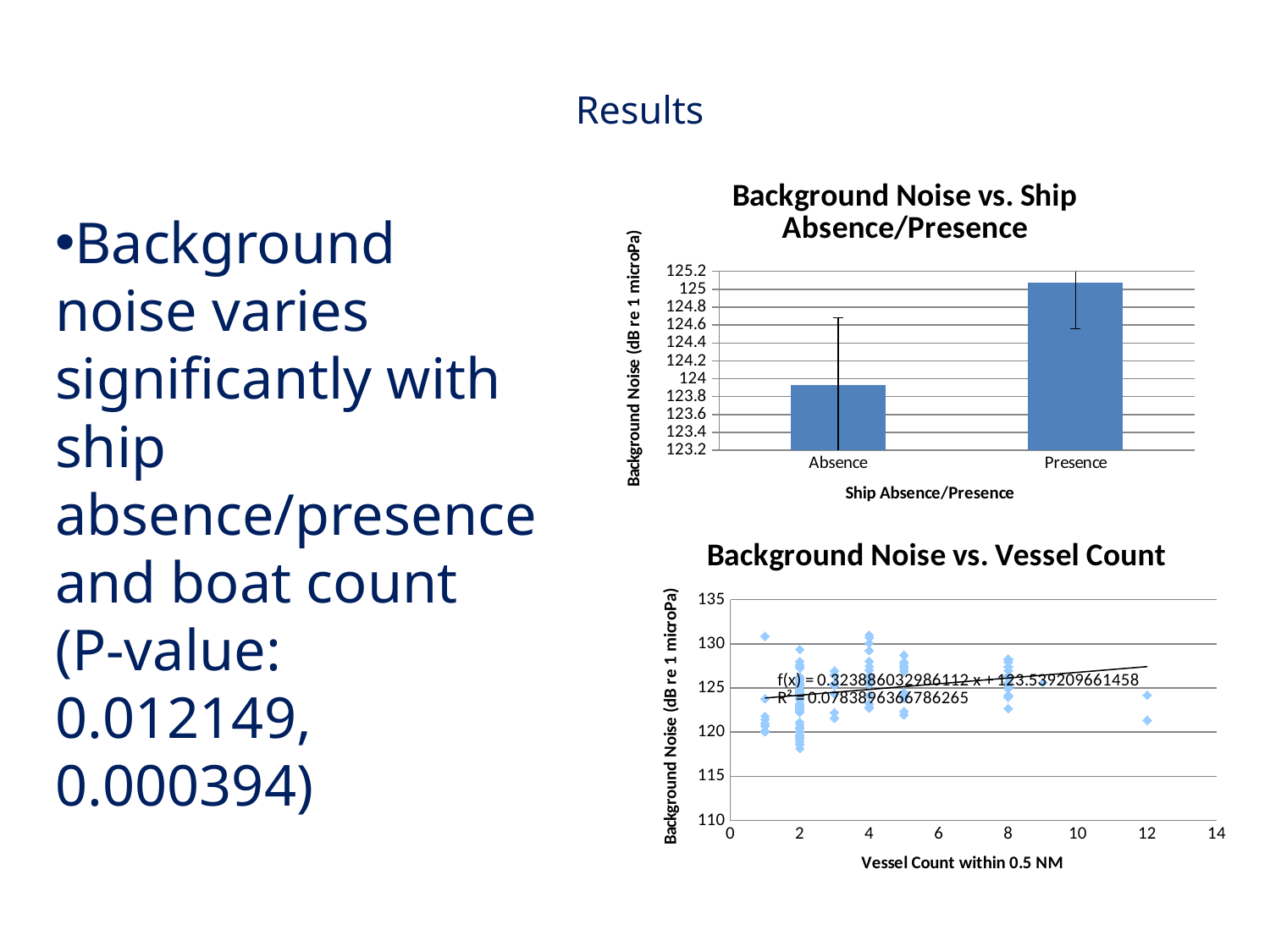
In the 'Background Noise vs. Ship Absence/Presence' chart, is the bar for Absence taller or shorter than the bar for Presence? shorter What is the y-axis title of the 'Background Noise vs. Ship Absence/Presence' chart? Background Noise (dB re 1 microPa) In the 'Background Noise vs. Ship Absence/Presence' chart, is the value for Presence greater or less than 124.8? greater In the 'Background Noise vs. Ship Absence/Presence' chart, which category has the higher background noise? Presence What kind of chart is the 'Background Noise vs. Ship Absence/Presence' chart? bar chart In the 'Background Noise vs. Ship Absence/Presence' chart, is the value for Absence greater or less than 124.2? less In the 'Background Noise vs. Vessel Count' chart, does the trendline rise or fall as vessel count increases? rise In the 'Background Noise vs. Ship Absence/Presence' chart, how many categories are shown on the x axis? 2 In the 'Background Noise vs. Ship Absence/Presence' chart, which category has the lower background noise? Absence What is the x-axis title of the 'Background Noise vs. Vessel Count' chart? Vessel Count within 0.5 NM What kind of chart is the 'Background Noise vs. Vessel Count' chart? scatter chart In the 'Background Noise vs. Vessel Count' chart, what R² value is printed for the trendline? 0.0783896366786265